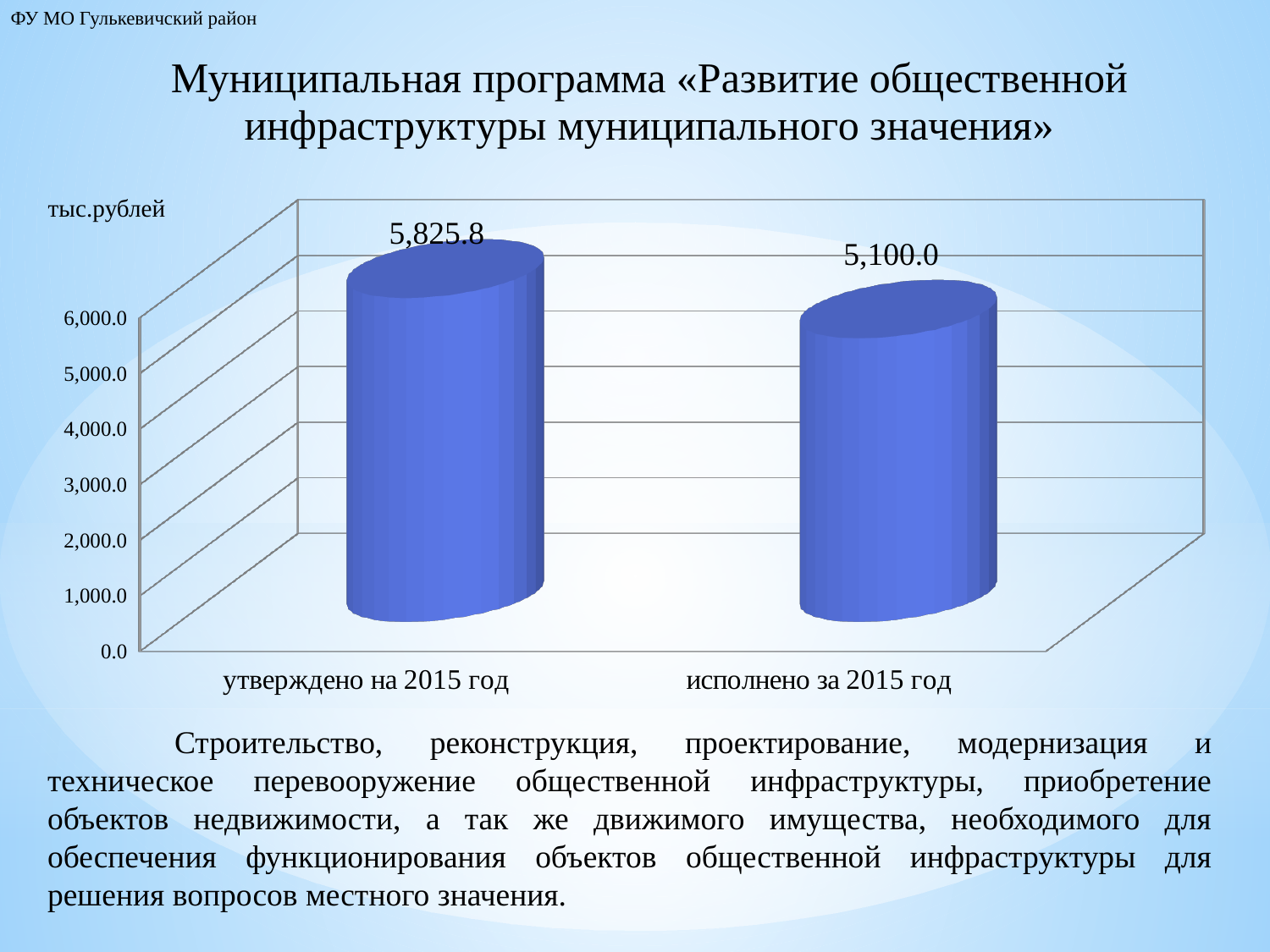
Which category has the lower value? исполнено за 2015 год Is the value for «утверждено на 2015 год» greater or less than 5,000.0? greater What is the value for «утверждено на 2015 год»? 5,825.8 Is the value for «утверждено на 2015 год» larger or smaller than the value for «исполнено за 2015 год»? larger What unit of measurement is indicated for the chart values? тыс.рублей What is the difference between the approved value (утверждено на 2015 год) and the executed value (исполнено за 2015 год)? 725.8 Is the value for «исполнено за 2015 год» greater or less than 6,000.0? less What is the value for «исполнено за 2015 год»? 5,100.0 How many categories are shown on the chart? 2 What kind of chart is shown on the slide? bar chart Do the values rise or fall from the first category to the second? fall Which category has the higher value? утверждено на 2015 год